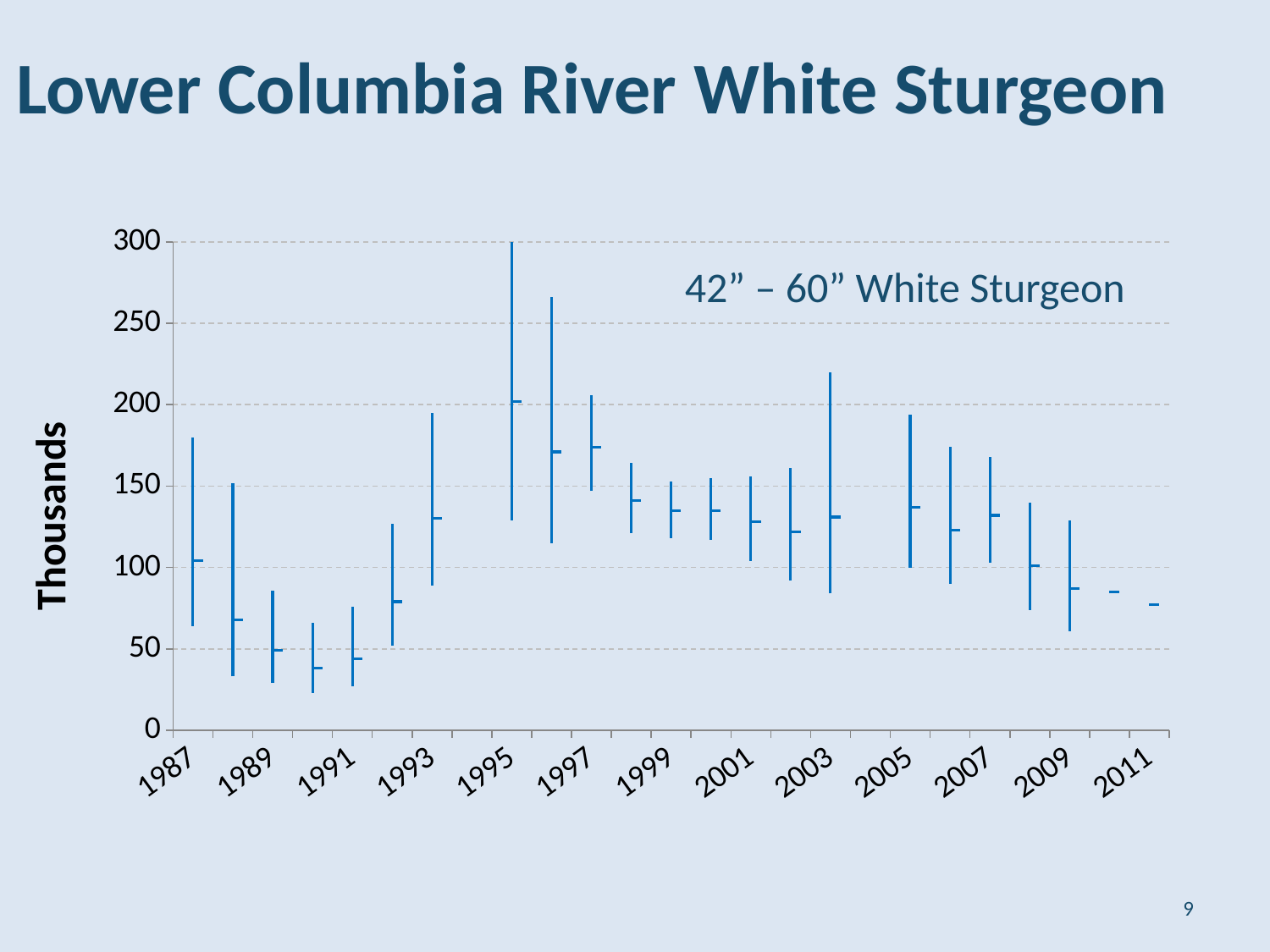
Which year has the larger estimated value, 1997 or 2011? 1997 What is the title of the chart on the slide? Lower Columbia River White Sturgeon Is the estimated value for 2010 greater or less than 100? less What is the label on the vertical axis of the chart? Thousands Is the estimated value for 1988 greater or less than 100? less Which year has the larger estimated value, 1995 or 1988? 1995 Is the estimated value for 1996 greater or less than 150? greater Do the estimated values generally rise or fall from 1997 to 2011? fall In which year is the estimated value (the horizontal tick) highest? 1995